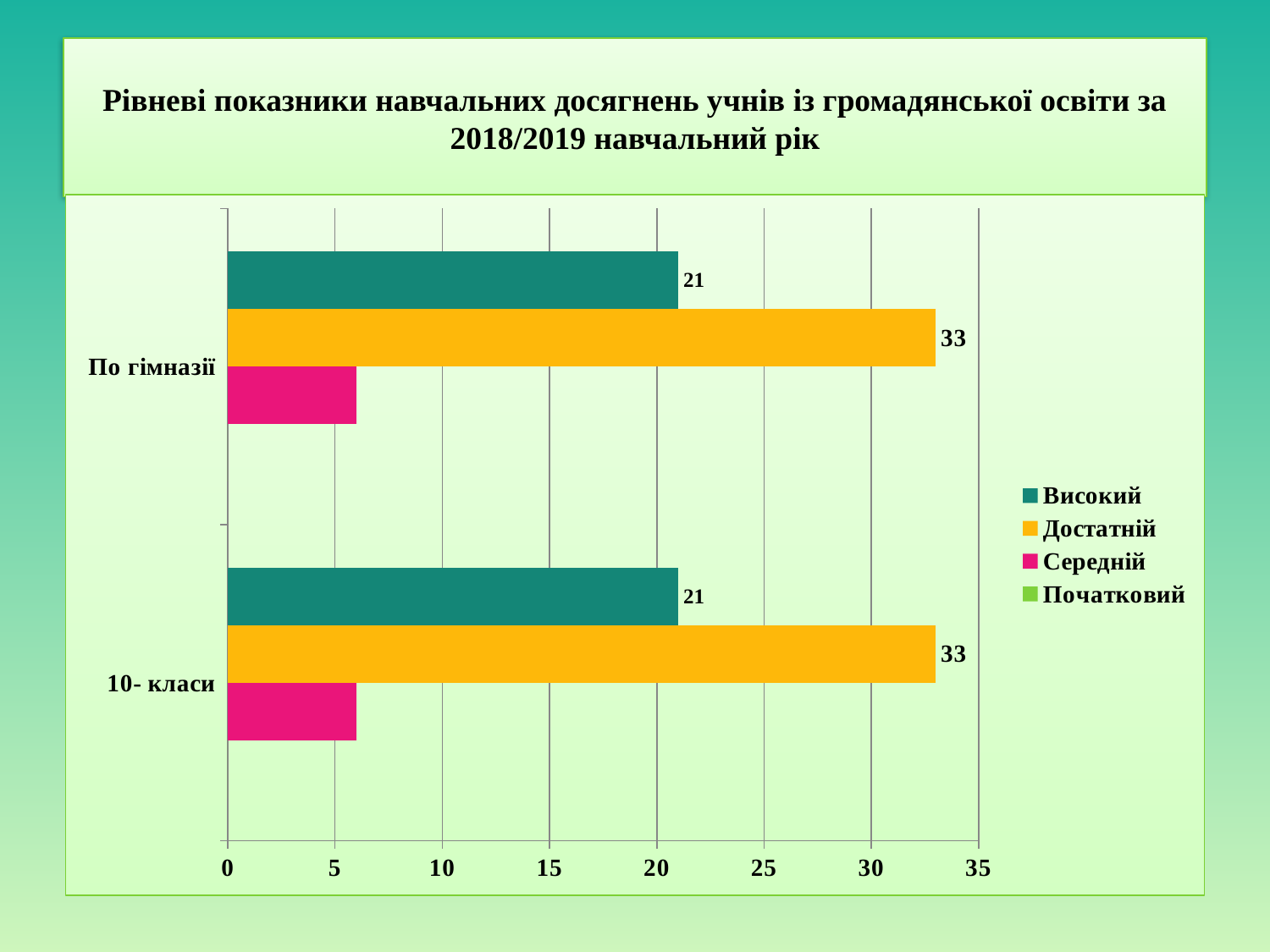
How many categories are shown on the vertical axis? 2 Is the value of Середній for 10- класи greater or less than 10? less Which is larger for По гімназії, Високий or Середній? Високий What is the value of Достатній for По гімназії? 33 How many series does the legend list? 4 Which series has the highest value for 10- класи? Достатній What is the value of Достатній for 10- класи? 33 What kind of chart is shown on the slide? bar chart What is the value of Високий for 10- класи? 21 Which legend entry is shown in pink? Середній What is the difference between Достатній and Високий for По гімназії? 12 What is the value of Високий for По гімназії? 21